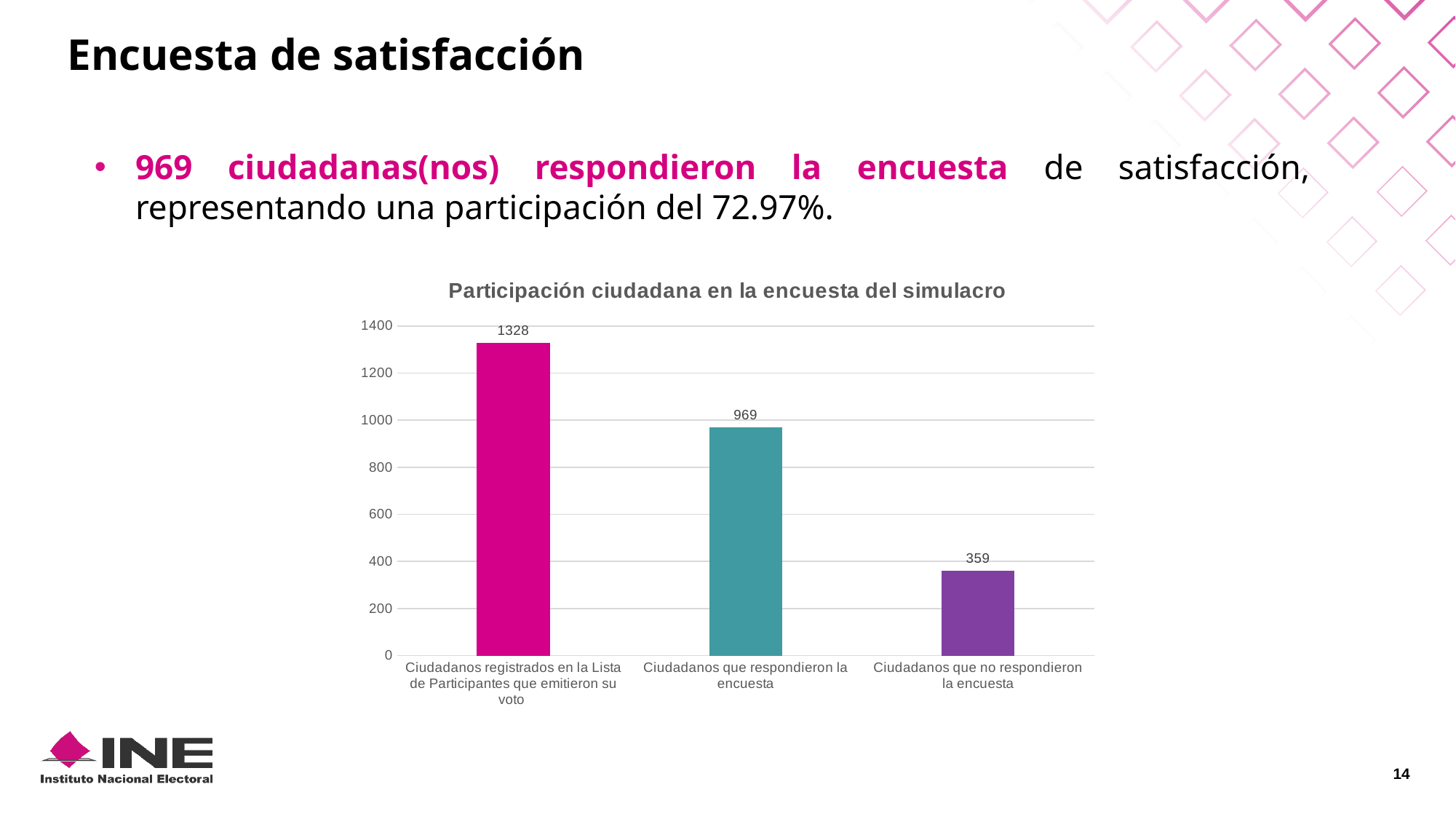
Is the value for 'Ciudadanos que no respondieron la encuesta' greater or less than 400? less What is the value for 'Ciudadanos registrados en la Lista de Participantes que emitieron su voto'? 1328 What is the value for 'Ciudadanos que no respondieron la encuesta'? 359 How many categories are shown in the chart? 3 What kind of chart is shown on the slide? bar chart What is the value for 'Ciudadanos que respondieron la encuesta'? 969 Which category has the lowest value? Ciudadanos que no respondieron la encuesta What is the difference between 'Ciudadanos que respondieron la encuesta' and 'Ciudadanos que no respondieron la encuesta'? 610 What is the title of the chart? Participación ciudadana en la encuesta del simulacro What is the difference between 'Ciudadanos registrados en la Lista de Participantes que emitieron su voto' and 'Ciudadanos que respondieron la encuesta'? 359 Which is larger: 'Ciudadanos que respondieron la encuesta' or 'Ciudadanos que no respondieron la encuesta'? Ciudadanos que respondieron la encuesta Which category has the highest value? Ciudadanos registrados en la Lista de Participantes que emitieron su voto